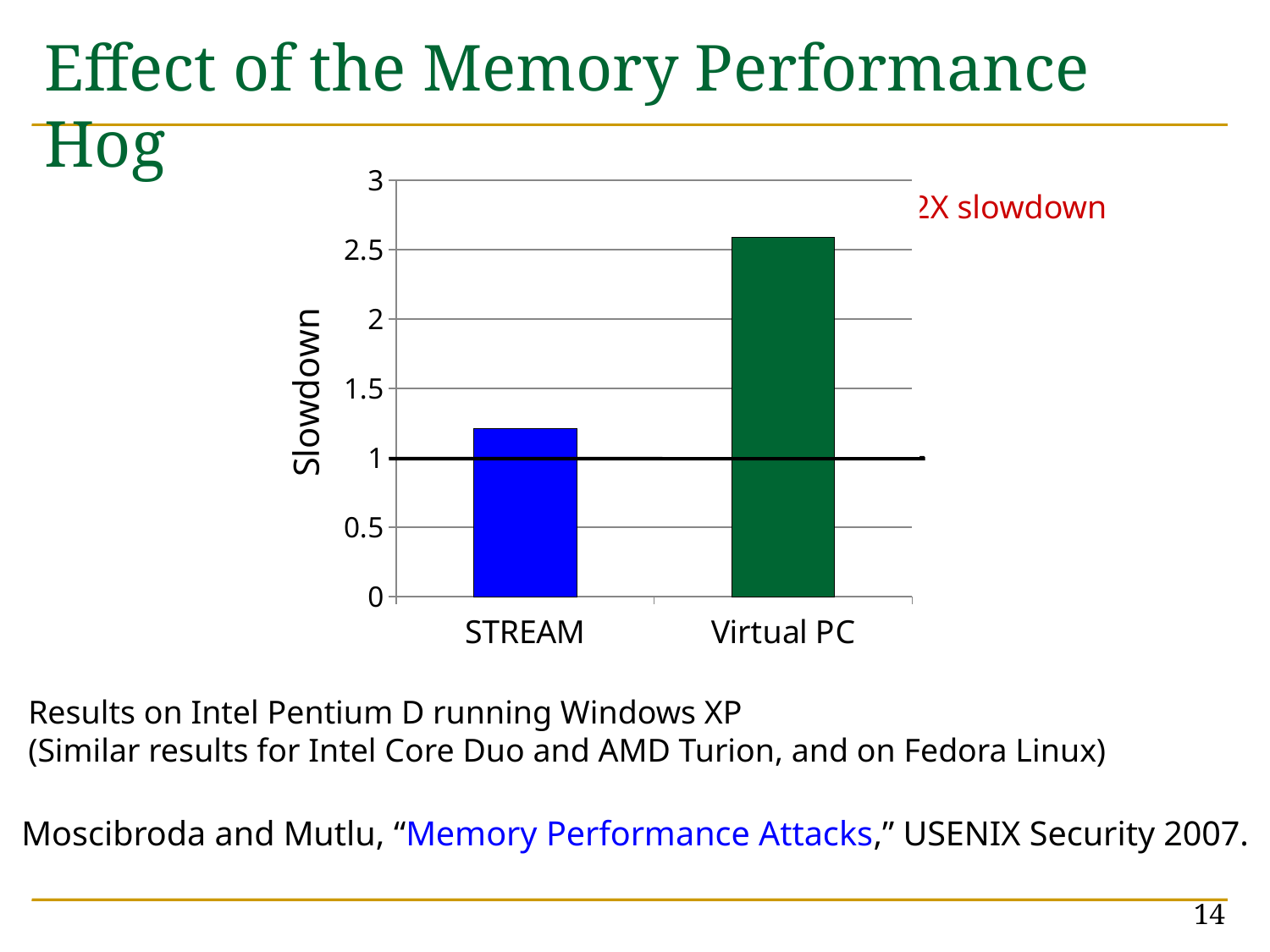
What is the label of the y axis? Slowdown Which has a larger slowdown, STREAM or Virtual PC? Virtual PC Is the slowdown for Virtual PC greater or less than 3? less Is the slowdown for Virtual PC greater or less than 2? greater What kind of chart is shown on the slide? bar chart Which category has the lowest slowdown? STREAM Is the slowdown for STREAM greater or less than 1.5? less How many categories are plotted on the x axis? 2 Which category has the highest slowdown? Virtual PC What colour is the bar for Virtual PC? green